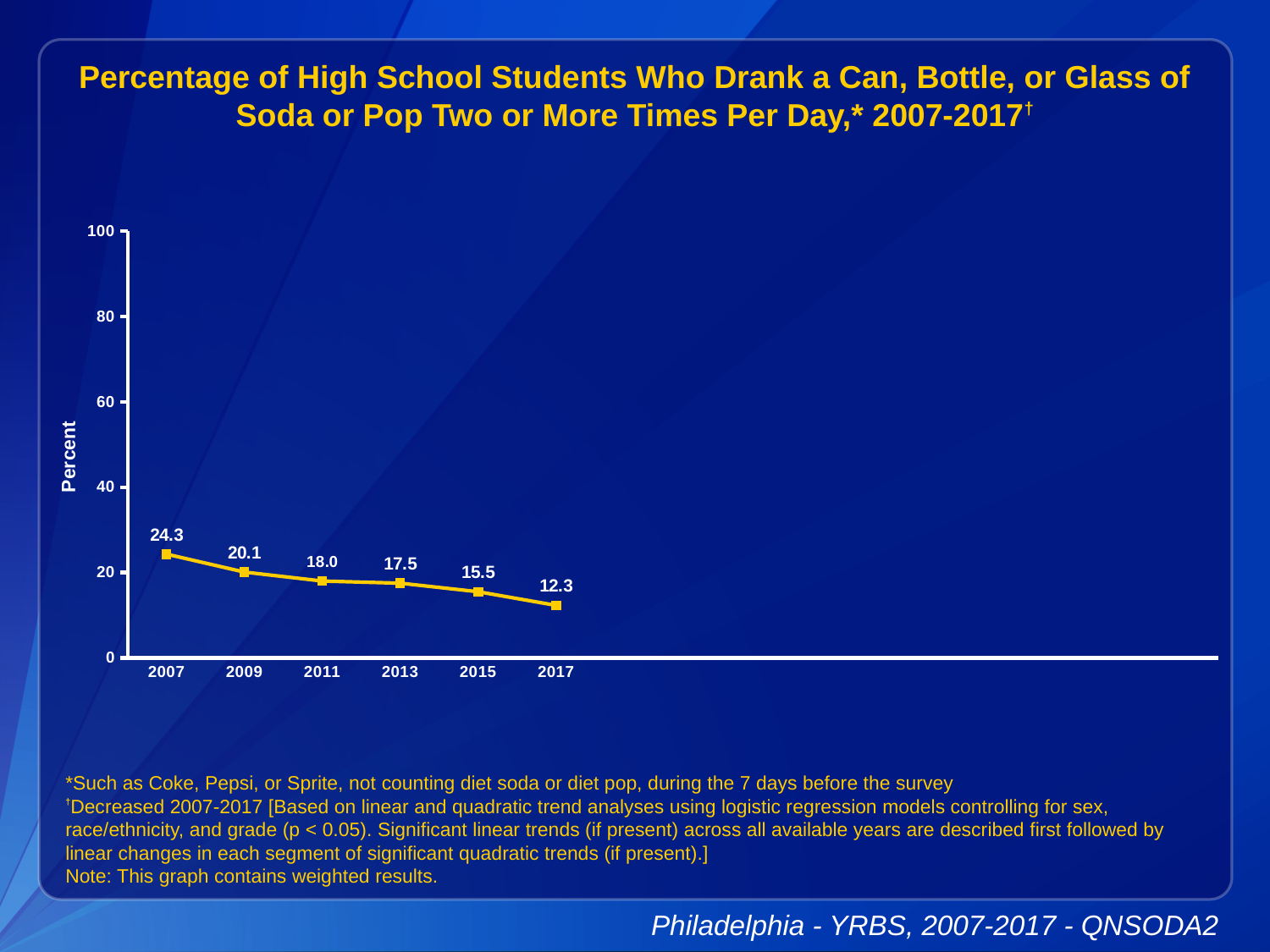
What kind of chart is shown? line chart Which is larger, the value for 2009 or the value for 2015? 2009 What is the value for 2017? 12.3 Which year has the highest value? 2007 Which year has the lowest value? 2017 What is the difference between the values for 2007 and 2017? 12.0 How many years are plotted on the chart? 6 What is the value for 2007? 24.3 Do the values rise or fall from 2007 to 2017? fall What is the label on the y axis? Percent Is the value for 2011 greater or less than 20? less What is the value for 2013? 17.5